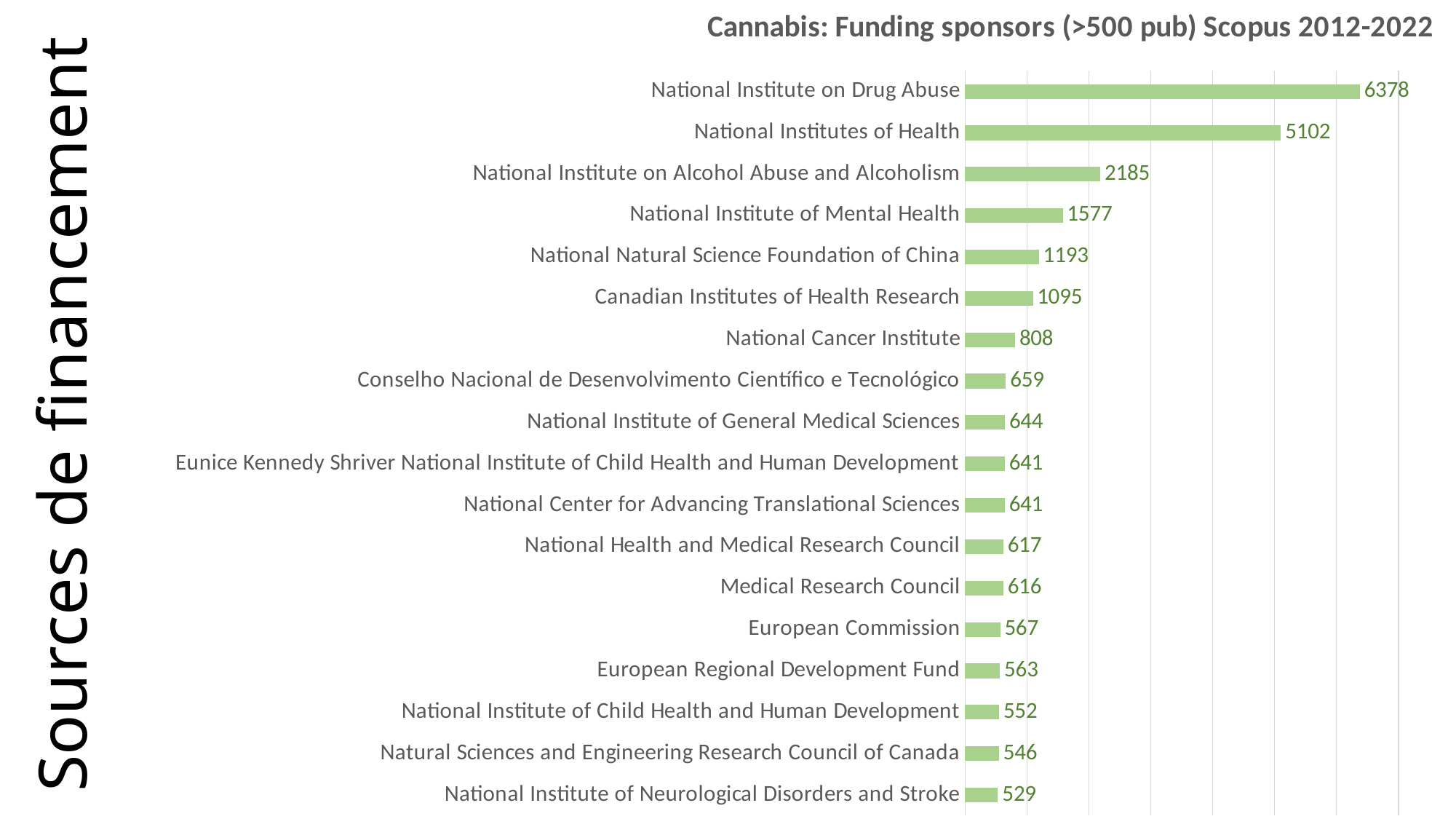
What is the value for Canadian Institutes of Health Research? 1095 How many funding sponsors are shown in the chart? 18 What is the value for European Commission? 567 Which funding sponsor has the highest value? National Institute on Drug Abuse What kind of chart is shown on the slide? Bar chart Which funding sponsor has the lowest value? National Institute of Neurological Disorders and Stroke What is the difference between the values for National Institute on Drug Abuse and National Institutes of Health? 1276 Which is larger, the value for National Cancer Institute or the value for National Natural Science Foundation of China? National Natural Science Foundation of China What is the value for National Institute on Drug Abuse? 6378 What is the difference between the values for National Institute on Alcohol Abuse and Alcoholism and National Institute of Mental Health? 608 What is the title of the chart? Cannabis: Funding sponsors (>500 pub) Scopus 2012-2022 What is the value for Medical Research Council? 616